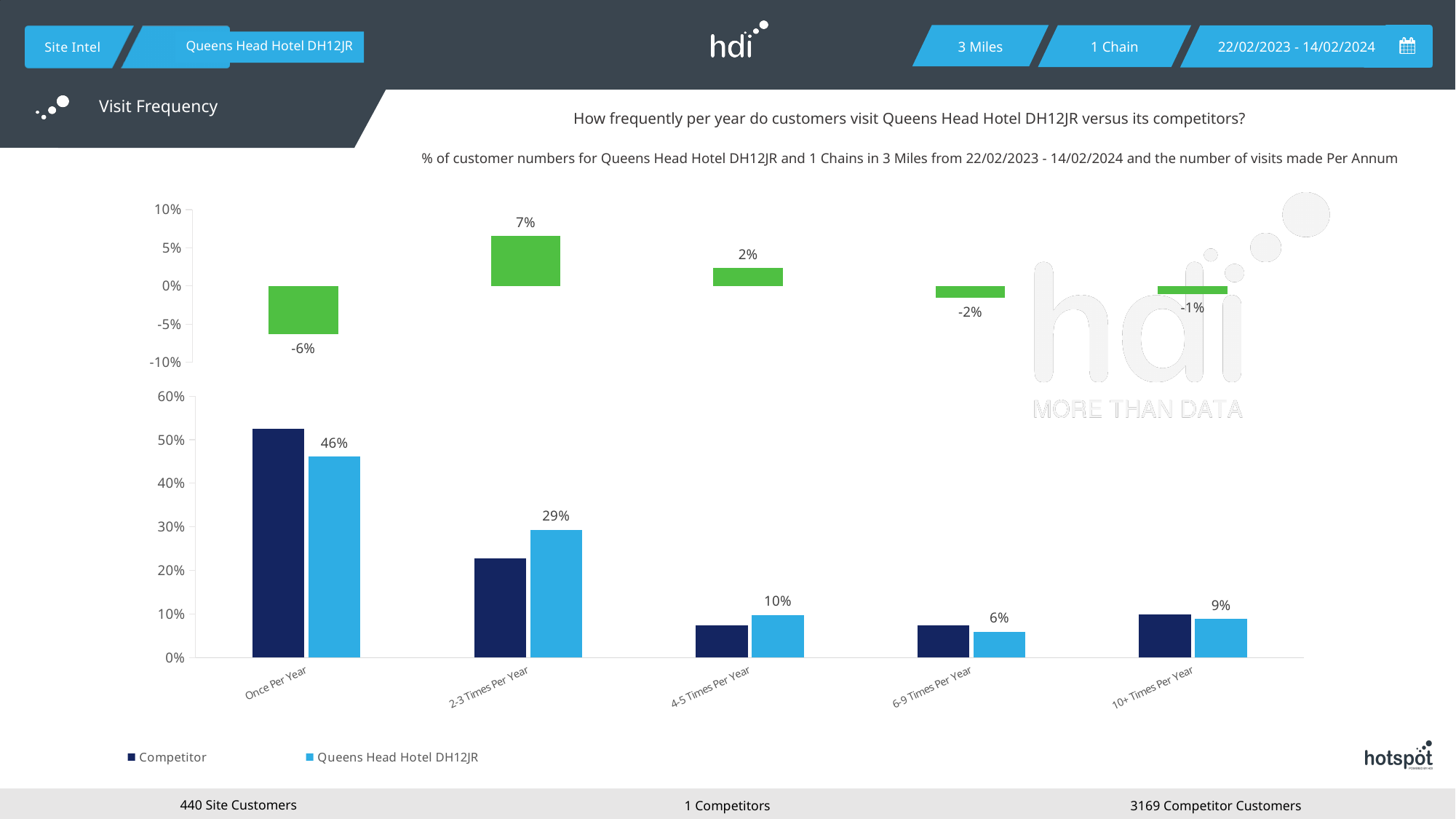
In the bottom bar chart, what is the Queens Head Hotel DH12JR value for 6-9 Times Per Year? 6% In the bottom bar chart, what is the difference between the Queens Head Hotel DH12JR values for Once Per Year and 2-3 Times Per Year? 17% In the top green chart, what is the value shown for 2-3 Times Per Year? 7% In the bottom bar chart, which category has the highest Queens Head Hotel DH12JR value? Once Per Year In the bottom bar chart, what percentage of Queens Head Hotel DH12JR customers visit Once Per Year? 46% In the bottom bar chart, which is larger for 2-3 Times Per Year: the Competitor bar or the Queens Head Hotel DH12JR bar? Queens Head Hotel DH12JR How many series does the legend of the bottom bar chart list? 2 In the top green chart, which category has the lowest value? Once Per Year In the top green chart, what is the value shown for Once Per Year? -6% In the bottom bar chart, what is the Queens Head Hotel DH12JR value for 2-3 Times Per Year? 29% In the bottom bar chart, is the Competitor value for 4-5 Times Per Year greater or less than 10%? less In the bottom bar chart, is the Competitor value for Once Per Year greater or less than 50%? greater